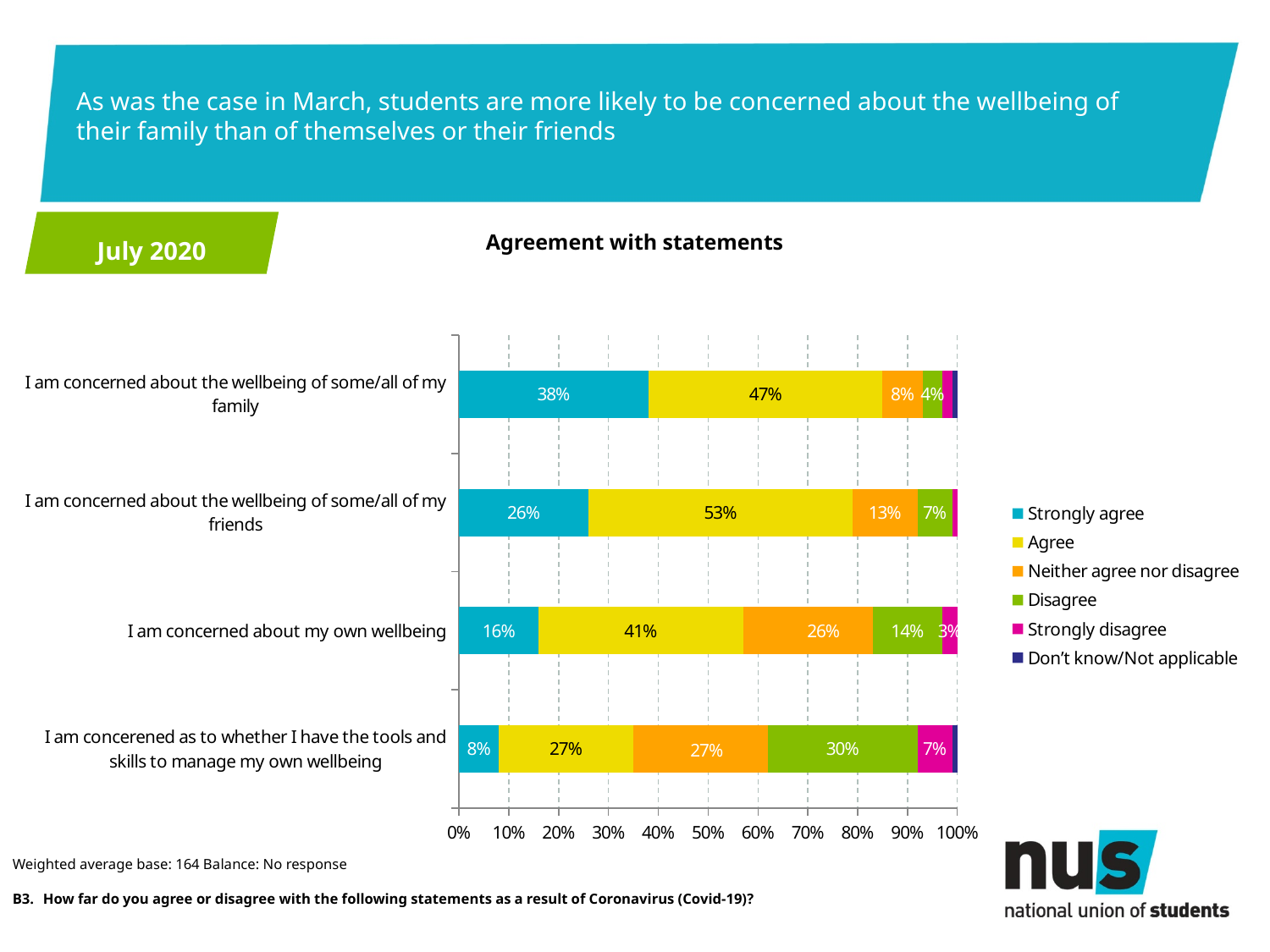
How many response categories does the legend list? 6 What percentage of students neither agree nor disagree with the statement 'I am concerned about my own wellbeing'? 26% What percentage of students agree with the statement 'I am concerned about the wellbeing of some/all of my friends'? 53% Which statement has the highest 'Strongly agree' percentage? I am concerned about the wellbeing of some/all of my family What is the title of the chart? Agreement with statements What percentage of students strongly agree with the statement 'I am concerned about the wellbeing of some/all of my family'? 38% Which statement has a larger 'Disagree' percentage: the friends statement or the own wellbeing statement? I am concerned about my own wellbeing What is the difference in percentage points between the 'Agree' value for the family statement and the 'Agree' value for the own wellbeing statement? 6 percentage points Which statement has the lowest 'Strongly agree' percentage? I am concerened as to whether I have the tools and skills to manage my own wellbeing What type of chart is shown on the slide? Stacked bar chart What percentage of students disagree with the statement 'I am concerened as to whether I have the tools and skills to manage my own wellbeing'? 30% How many statements are shown in the chart? 4